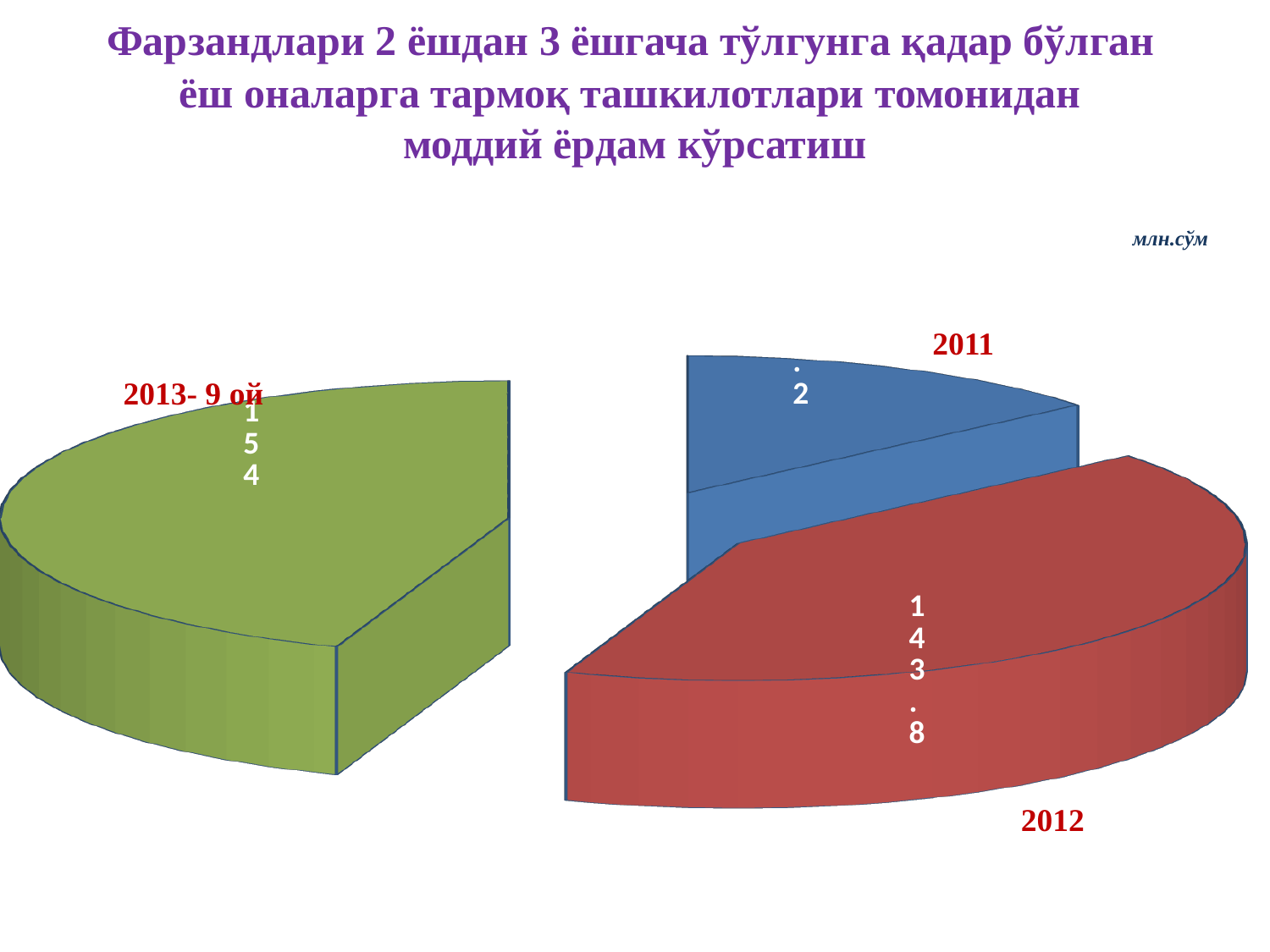
How many slices does the pie chart have? 3 Which category has the largest slice? 2013- 9 ой What kind of chart is shown on the slide? pie chart What is the value for 2012? 143.8 Which is larger, the value for 2012 or the value for 2013- 9 ой? 2013- 9 ой What is the value for 2013- 9 ой? 154 Which category has the smallest slice? 2011 What is the difference between the value for 2013- 9 ой and the value for 2012? 10.2 What colour is the slice for 2012? red What unit is indicated for the chart values? млн.сўм